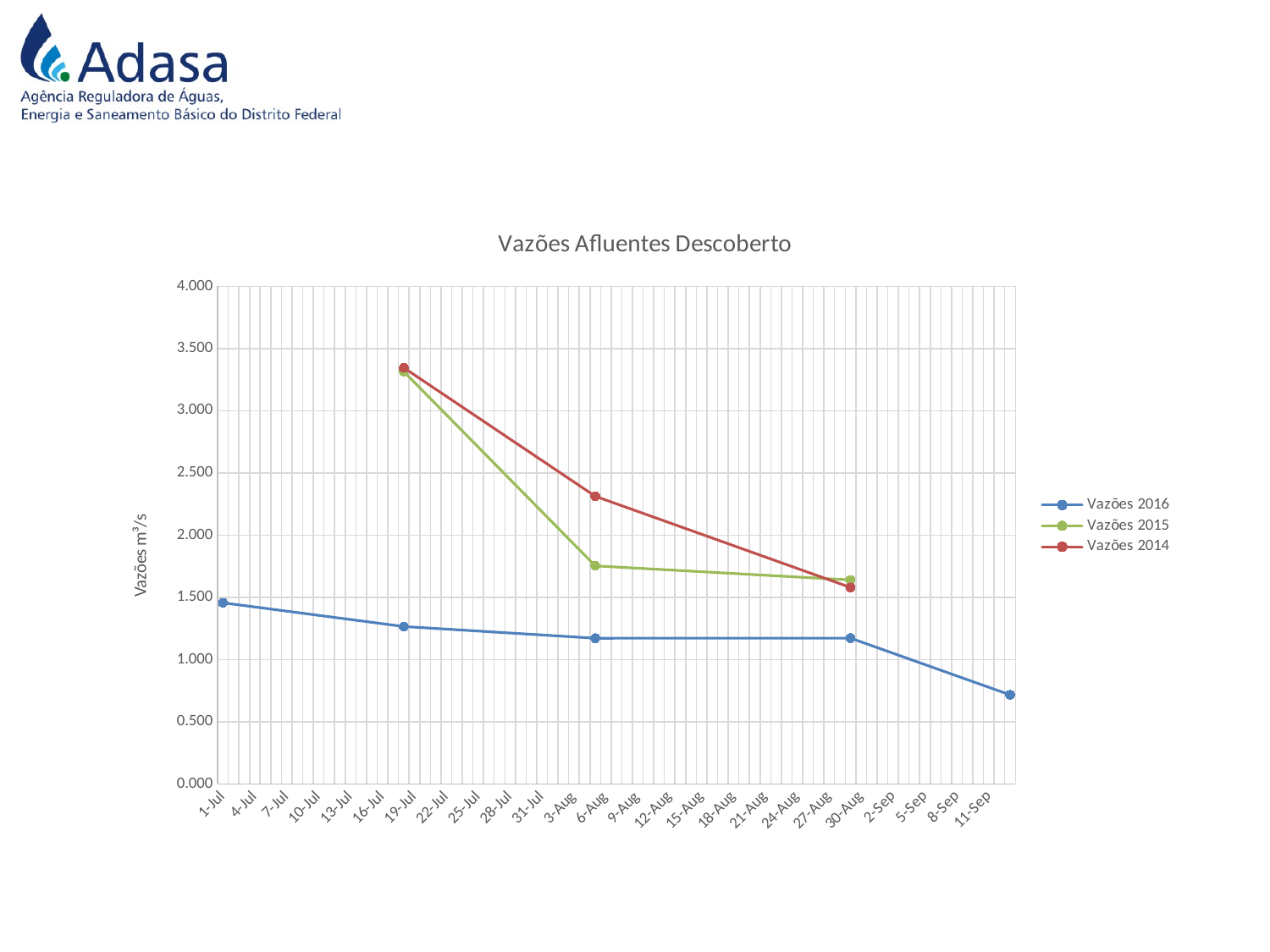
How many data points are plotted for the Vazões 2014 series? 3 What is the label of the vertical axis? Vazões m³/s What is the title of the chart? Vazões Afluentes Descoberto Which series has the lowest plotted value on the chart? Vazões 2016 On 6-Aug, which series has the larger value, Vazões 2014 or Vazões 2015? Vazões 2014 How many data points are plotted for the Vazões 2016 series? 5 Is the value for Vazões 2015 on 6-Aug greater or less than 2.000? less How many series does the legend list? 3 Is the value for Vazões 2016 on 11-Sep greater or less than 1.000? less Is the value for Vazões 2014 on 6-Aug greater or less than 2.000? greater What kind of chart is shown on the slide? line chart Do the values of the Vazões 2014 series rise or fall along the x axis? fall